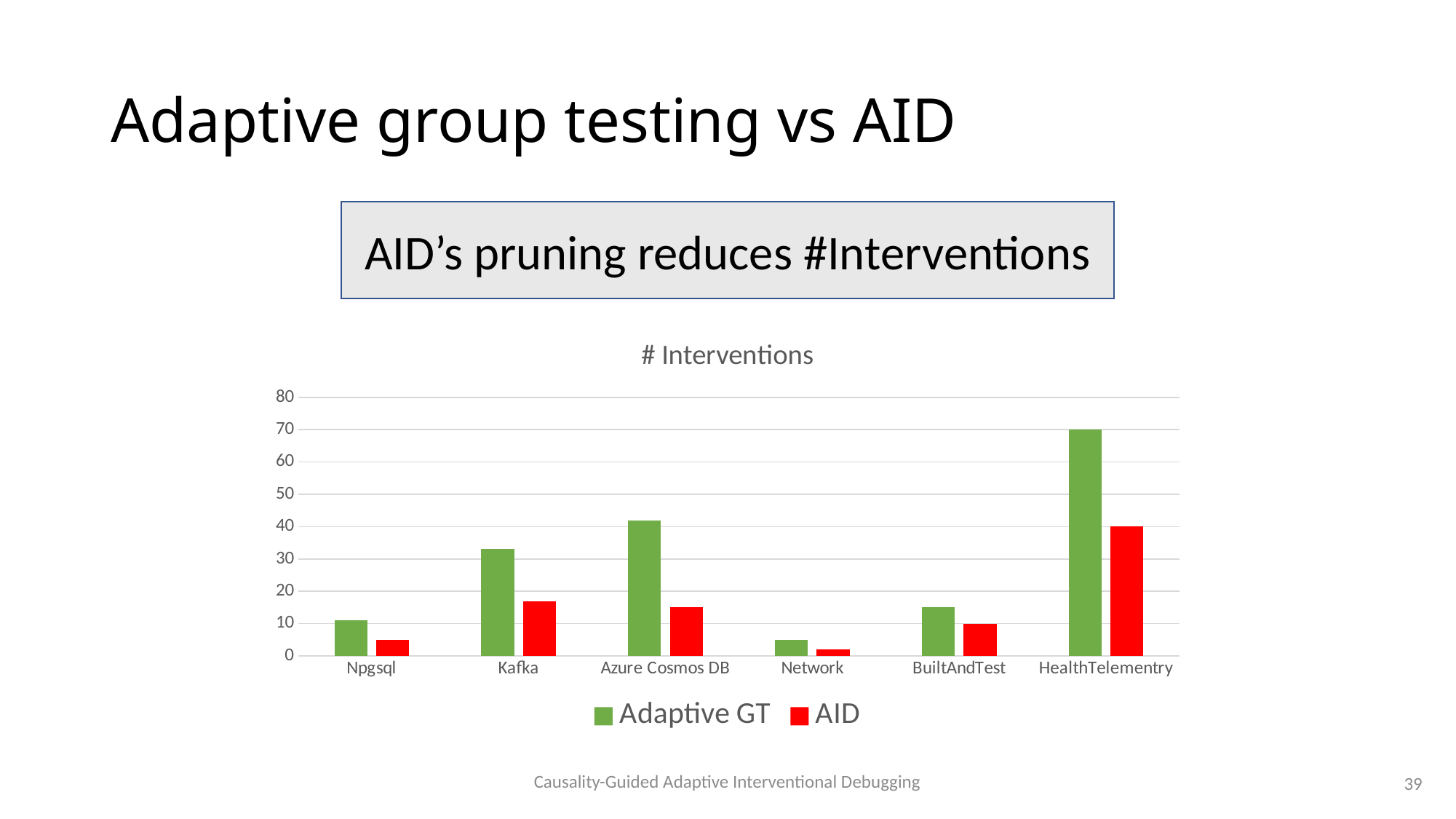
For Azure Cosmos DB, which is larger: the Adaptive GT value or the AID value? Adaptive GT Is the AID value for Azure Cosmos DB greater or less than 20? less Is the Adaptive GT value for Kafka greater or less than 30? greater What is the Adaptive GT value for HealthTelementry? 70 What kind of chart is shown on the slide? bar chart How many categories are shown on the x axis? 6 How many series does the legend list? 2 Which category has the highest Adaptive GT value? HealthTelementry Which category has the lowest AID value? Network What is the title of the chart? # Interventions Is the Adaptive GT value for Network greater or less than 10? less What is the AID value for HealthTelementry? 40